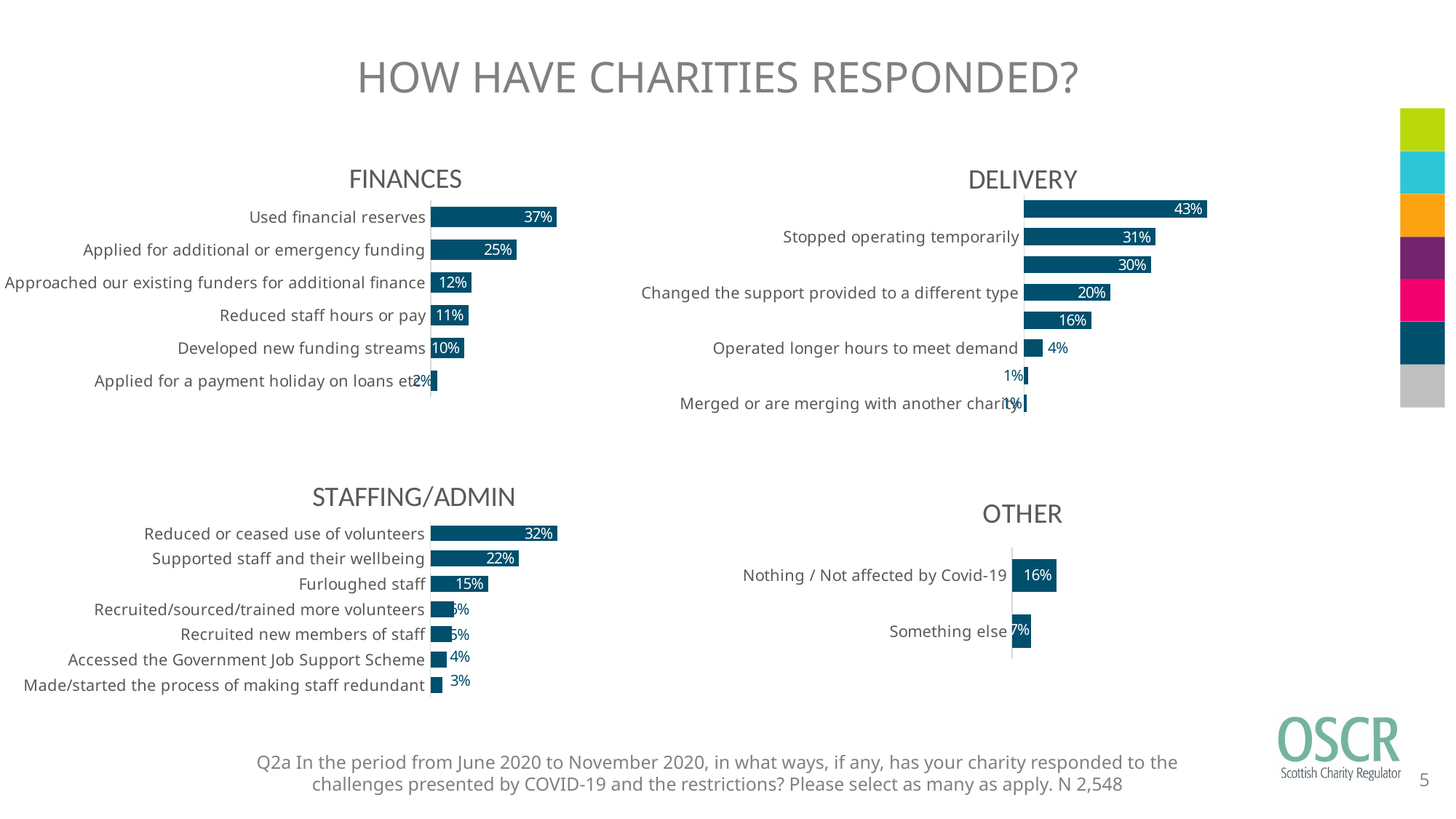
In the DELIVERY chart, what is the value for 'Changed the support provided to a different type'? 20% In the FINANCES chart, which response has the lowest value? Applied for a payment holiday on loans etc In the STAFFING/ADMIN chart, which response has the highest value? Reduced or ceased use of volunteers In the FINANCES chart, what percentage of charities used financial reserves? 37% In the OTHER chart, what is the value for 'Nothing / Not affected by Covid-19'? 16% In the FINANCES chart, which response has the highest value? Used financial reserves In the STAFFING/ADMIN chart, what percentage of charities furloughed staff? 15% How many categories are shown in the STAFFING/ADMIN chart? 7 In the FINANCES chart, what is the difference between 'Used financial reserves' and 'Applied for additional or emergency funding'? 12% In the DELIVERY chart, what percentage of charities stopped operating temporarily? 31% What type of chart is the OTHER chart? Bar chart In the DELIVERY chart, which is larger: 'Stopped operating temporarily' or 'Operated longer hours to meet demand'? Stopped operating temporarily